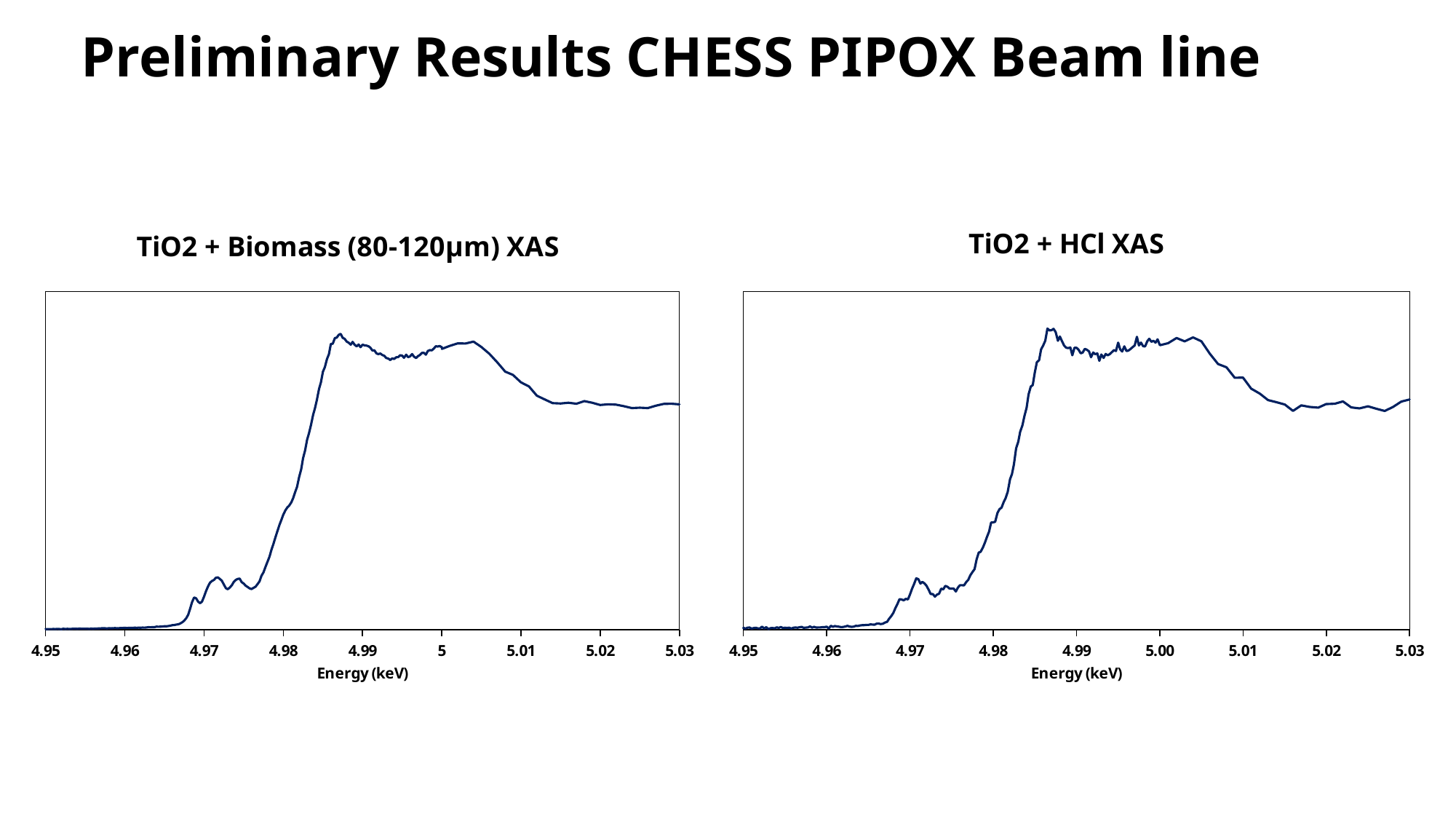
What kind of chart is the 'TiO2 + Biomass (80-120µm) XAS' chart on the left? line chart On the 'TiO2 + HCl XAS' chart, is the value higher at 4.99 keV or at 5.02 keV? 4.99 keV On the 'TiO2 + Biomass (80-120µm) XAS' chart, how many tick labels are shown on the x axis? 9 On the 'TiO2 + HCl XAS' chart, how many lines are plotted? 1 What is the title of the chart on the left of the slide? TiO2 + Biomass (80-120µm) XAS On the 'TiO2 + Biomass (80-120µm) XAS' chart, does the line rise or fall between 5.00 and 5.02 keV? fall On the 'TiO2 + Biomass (80-120µm) XAS' chart, is the value higher at 4.96 keV or at 4.99 keV? 4.99 keV What kind of chart is the 'TiO2 + HCl XAS' chart on the right? line chart On the 'TiO2 + Biomass (80-120µm) XAS' chart, how many lines are plotted? 1 On the 'TiO2 + HCl XAS' chart, what is the lowest x-axis tick label shown? 4.95 On the 'TiO2 + HCl XAS' chart, does the line rise or fall between 4.97 and 4.99 keV? rise On the 'TiO2 + HCl XAS' chart, what is the x-axis label? Energy (keV)